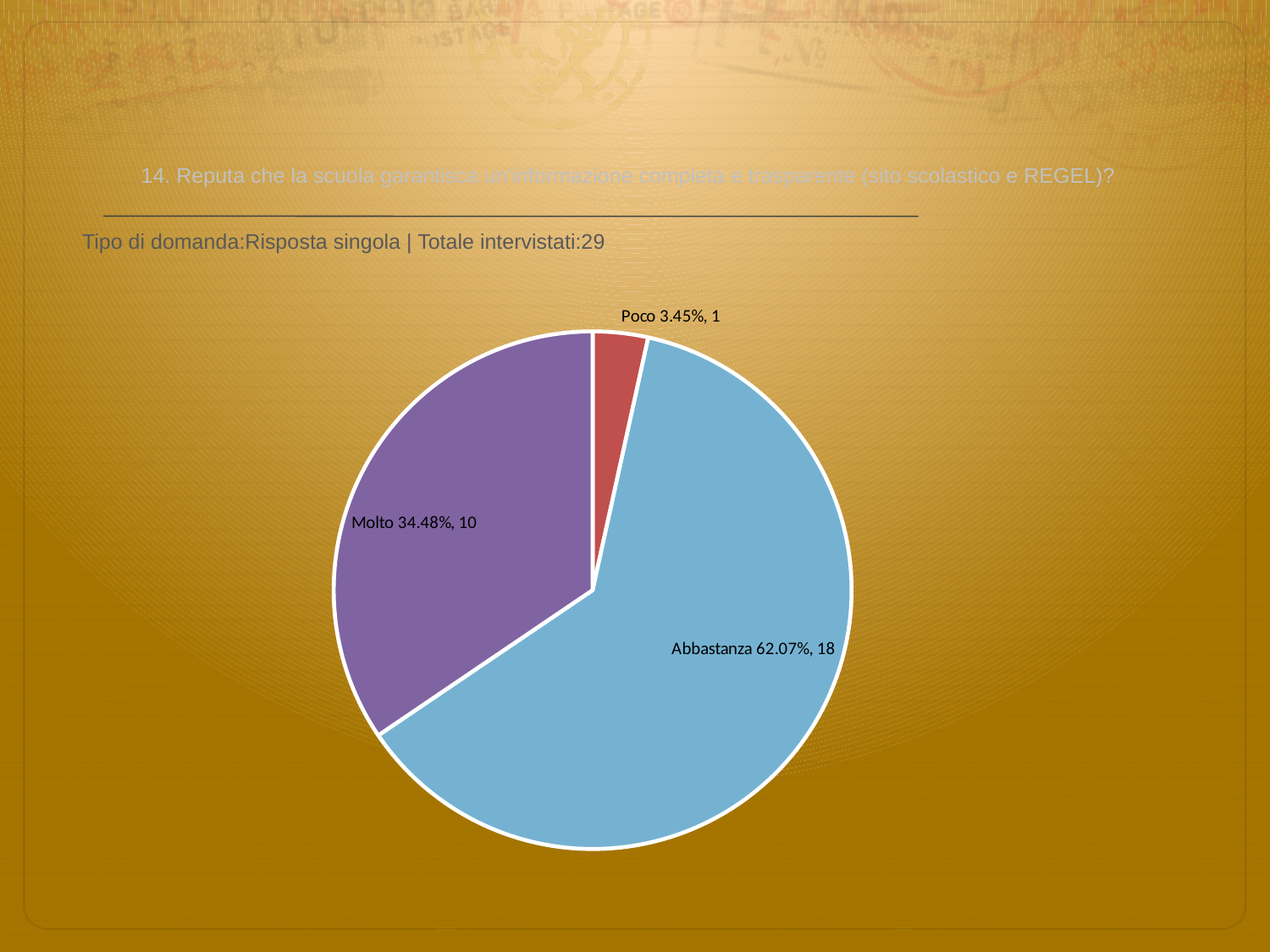
What type of chart is shown on the slide? Pie chart How many more respondents answered "Abbastanza" than "Molto"? 8 What percentage of respondents answered "Abbastanza"? 62.07% How many respondents answered "Molto"? 10 What is the total number of respondents across all slices of the pie? 29 How many categories are shown in the pie chart? 3 What percentage of respondents answered "Poco"? 3.45% Which has more respondents, "Molto" or "Poco"? Molto What colour is the "Molto" slice of the pie? Purple Which response category has the smallest share of the pie? Poco How many respondents answered "Abbastanza"? 18 Which response category has the largest share of the pie? Abbastanza